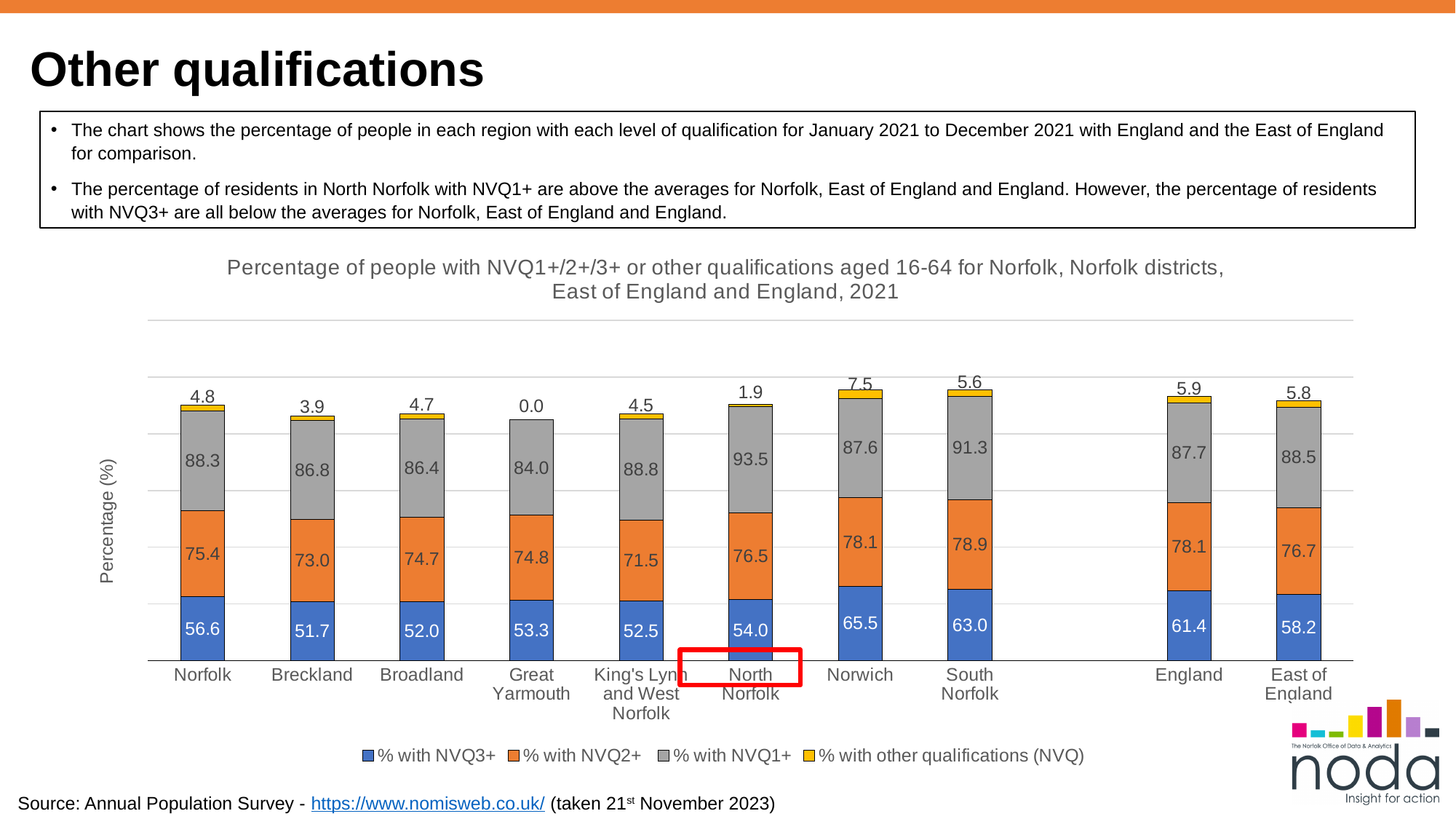
What kind of chart is shown on the slide? Stacked bar chart What is the % with NVQ2+ for King's Lynn and West Norfolk? 71.5 What is the % with NVQ1+ for North Norfolk? 93.5 How much higher is the % with NVQ3+ in Norwich than in Norfolk? 8.9 What is the % with NVQ3+ for Norwich? 65.5 How many series does the chart legend list? 4 Which area has the highest % with other qualifications (NVQ)? Norwich Which area has the lowest % with NVQ3+? Breckland What is the % with other qualifications (NVQ) for Great Yarmouth? 0.0 Which area has the highest % with NVQ3+? Norwich How many areas are shown on the x axis of the chart? 10 Which has a higher % with NVQ2+, South Norfolk or England? South Norfolk